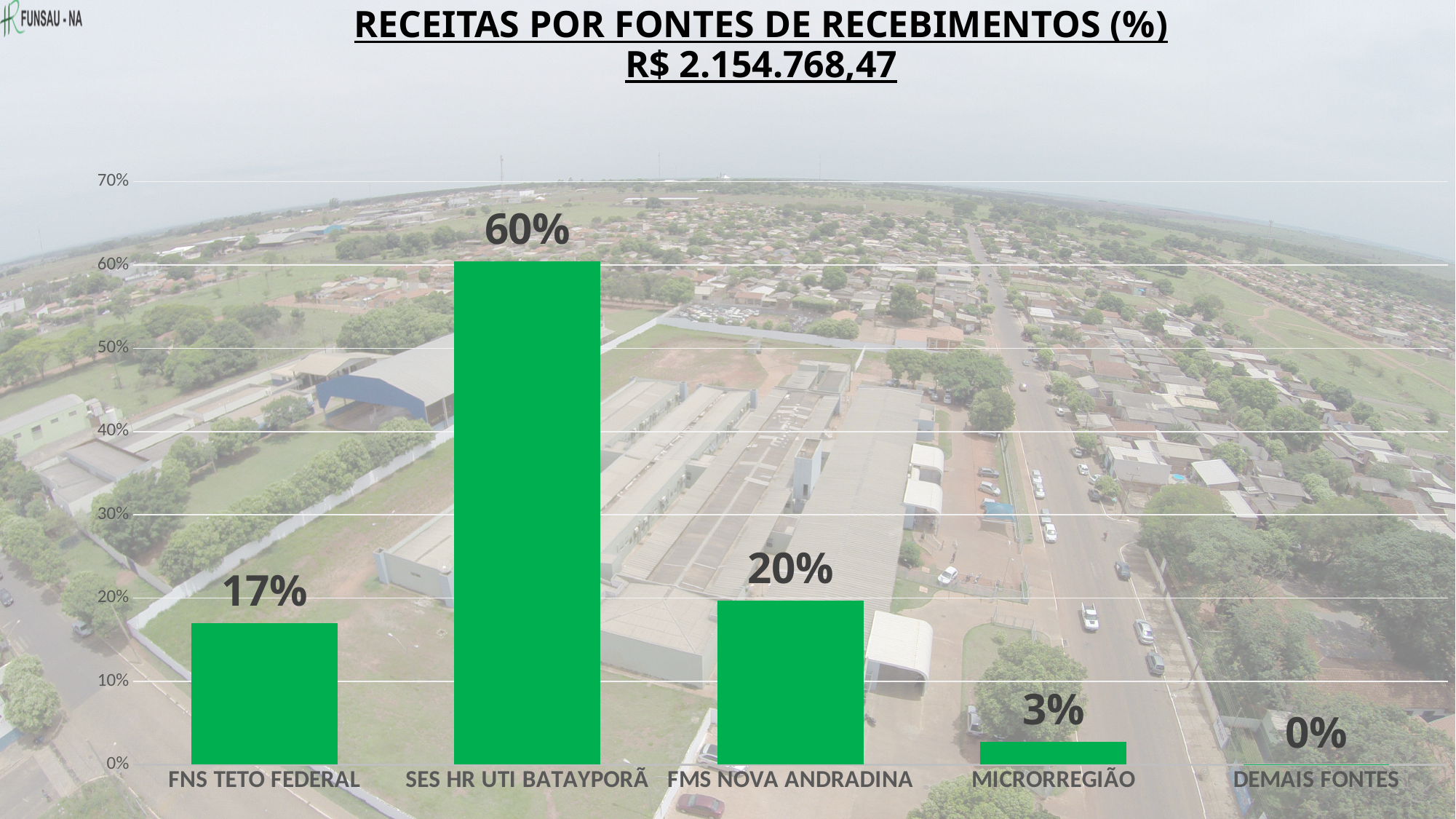
Which category has the highest value? SES HR UTI BATAYPORÃ What is the value for SES HR UTI BATAYPORÃ? 60% What is the value for DEMAIS FONTES? 0% Is the value for FNS TETO FEDERAL greater or less than 20%? less What total amount is shown in the chart title? R$ 2.154.768,47 Which is larger, the value for FNS TETO FEDERAL or the value for FMS NOVA ANDRADINA? FMS NOVA ANDRADINA What is the value for FNS TETO FEDERAL? 17% What is the value for MICRORREGIÃO? 3% What is the difference between the values for SES HR UTI BATAYPORÃ and FMS NOVA ANDRADINA? 40% Which category has the lowest value? DEMAIS FONTES What kind of chart is shown on the slide? bar chart How many categories are shown on the chart? 5